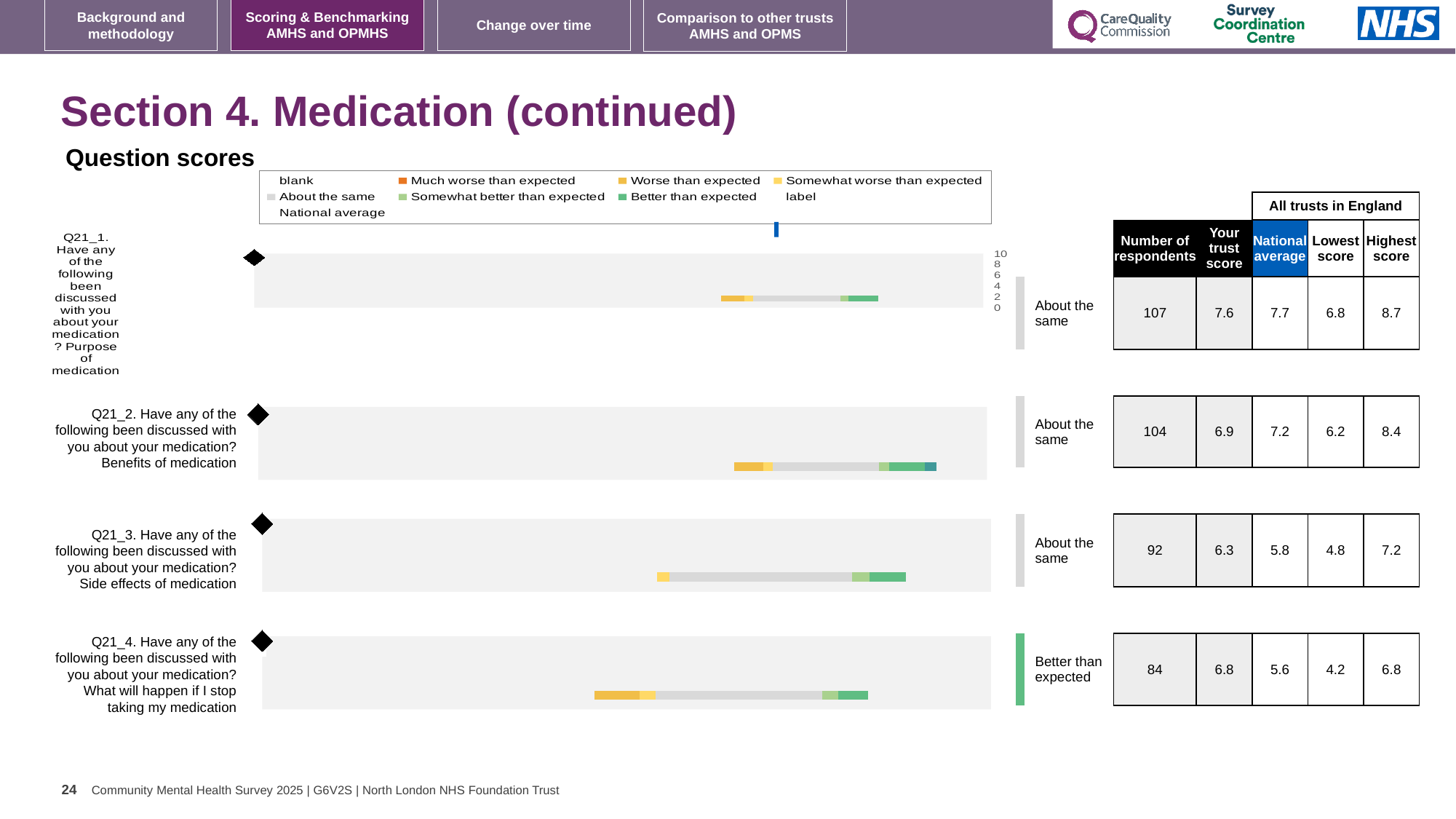
For the Q21_4 chart (What will happen if I stop taking my medication), what is the highest score among all trusts in England? 6.8 For the Q21_3 chart (Side effects of medication), what is the national average? 5.8 For the Q21_2 chart (Benefits of medication), what is the 'Your trust score' value? 6.9 In the legend, what colour represents 'Much worse than expected'? orange For Q21_2, which is larger: the trust score or the national average? national average (7.2) For Q21_3, what is the difference between the trust score (6.3) and the national average (5.8)? 0.5 How many question charts (Q21_1 to Q21_4) are shown on the slide? 4 What comparison label is shown next to the Q21_4 chart? Better than expected Which question has the highest 'Your trust score' on the slide? Q21_1 (7.6) Which question has the lowest number of respondents? Q21_4 (84) For the Q21_1 chart (Purpose of medication), what is the number of respondents shown in the table? 107 What kind of chart is used to show the question scores on this slide? bar chart